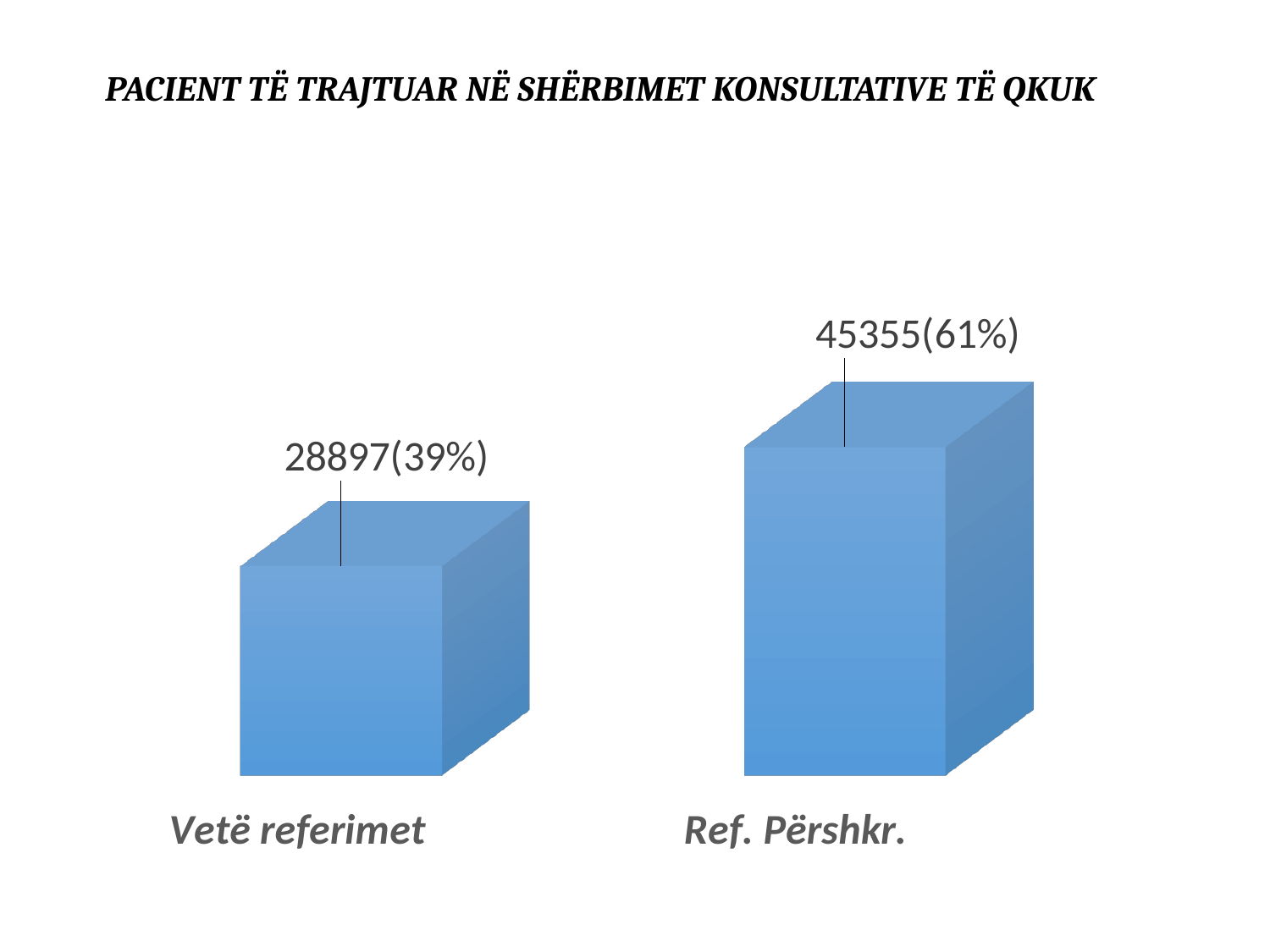
What percentage share is shown for Vetë referimet? 39% How many categories are shown in the chart? 2 Which is larger, the value for Vetë referimet or the value for Ref. Përshkr.? Ref. Përshkr. What is the total of the two values shown in the chart? 74252 What kind of chart is shown on the slide? Bar chart Which category has the lowest value? Vetë referimet Which category has the highest value? Ref. Përshkr. What is the title of the slide? PACIENT TË TRAJTUAR NË SHËRBIMET KONSULTATIVE TË QKUK What is the value shown for Ref. Përshkr.? 45355(61%) What is the value shown for Vetë referimet? 28897(39%) What is the difference between the values for Ref. Përshkr. and Vetë referimet? 16458 What percentage share is shown for Ref. Përshkr.? 61%